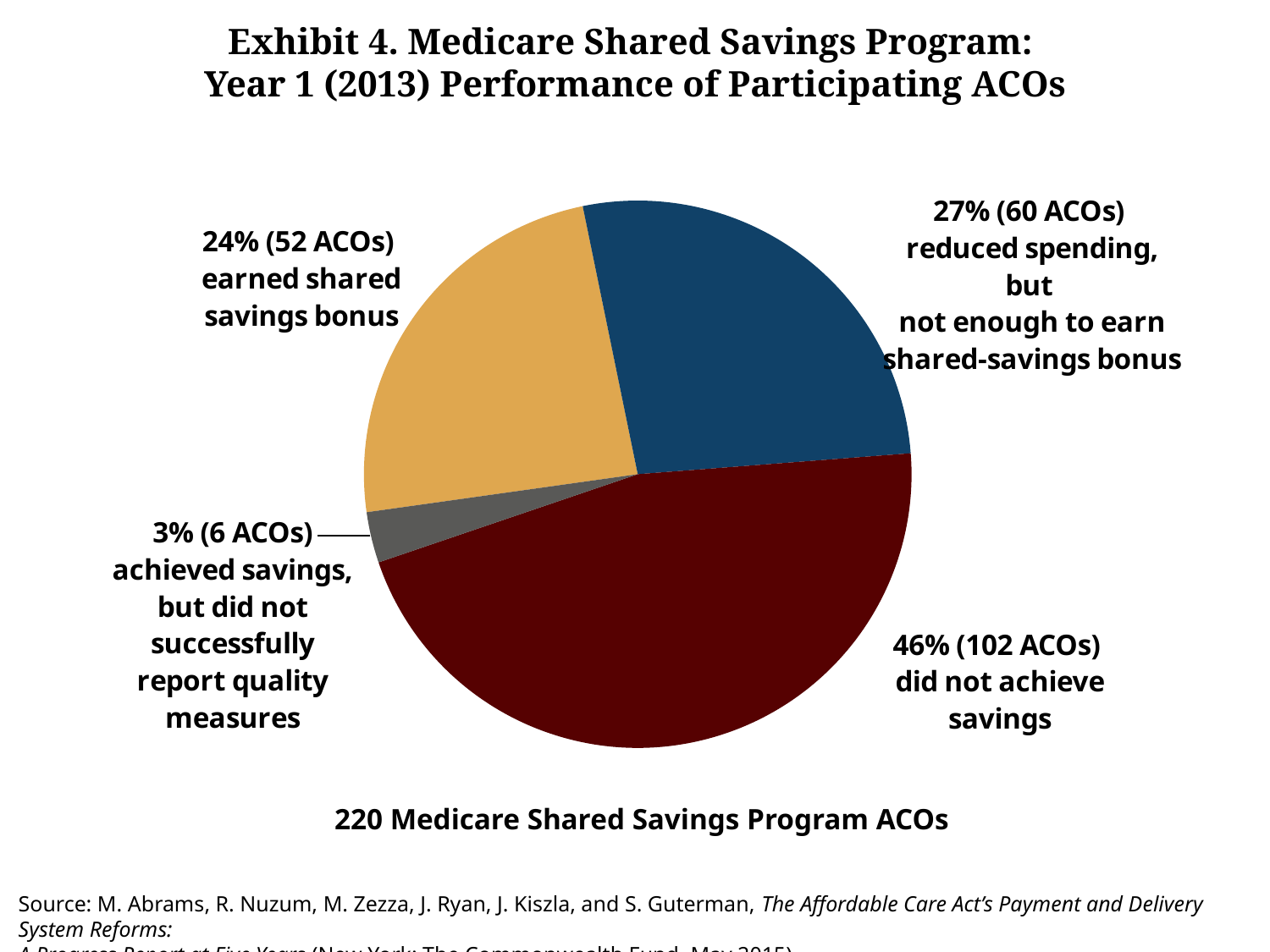
How many ACOs earned a shared savings bonus? 52 ACOs What is the difference in percentage points between ACOs that did not achieve savings and ACOs that earned a shared savings bonus? 22 percentage points What percentage of ACOs did not achieve savings? 46% What colour is the slice for ACOs that did not achieve savings? Dark red Which is larger: the share of ACOs that reduced spending but not enough to earn a bonus, or the share that earned a shared savings bonus? Reduced spending, but not enough to earn shared-savings bonus How many Medicare Shared Savings Program ACOs are represented in the chart in total? 220 What kind of chart is shown on the slide? Pie chart Which category represents the smallest share of the pie? Achieved savings, but did not successfully report quality measures What percentage of ACOs reduced spending but not enough to earn a shared-savings bonus? 27% How many ACOs achieved savings but did not successfully report quality measures? 6 ACOs Which category represents the largest share of the pie? Did not achieve savings How many slices does the pie chart have? 4